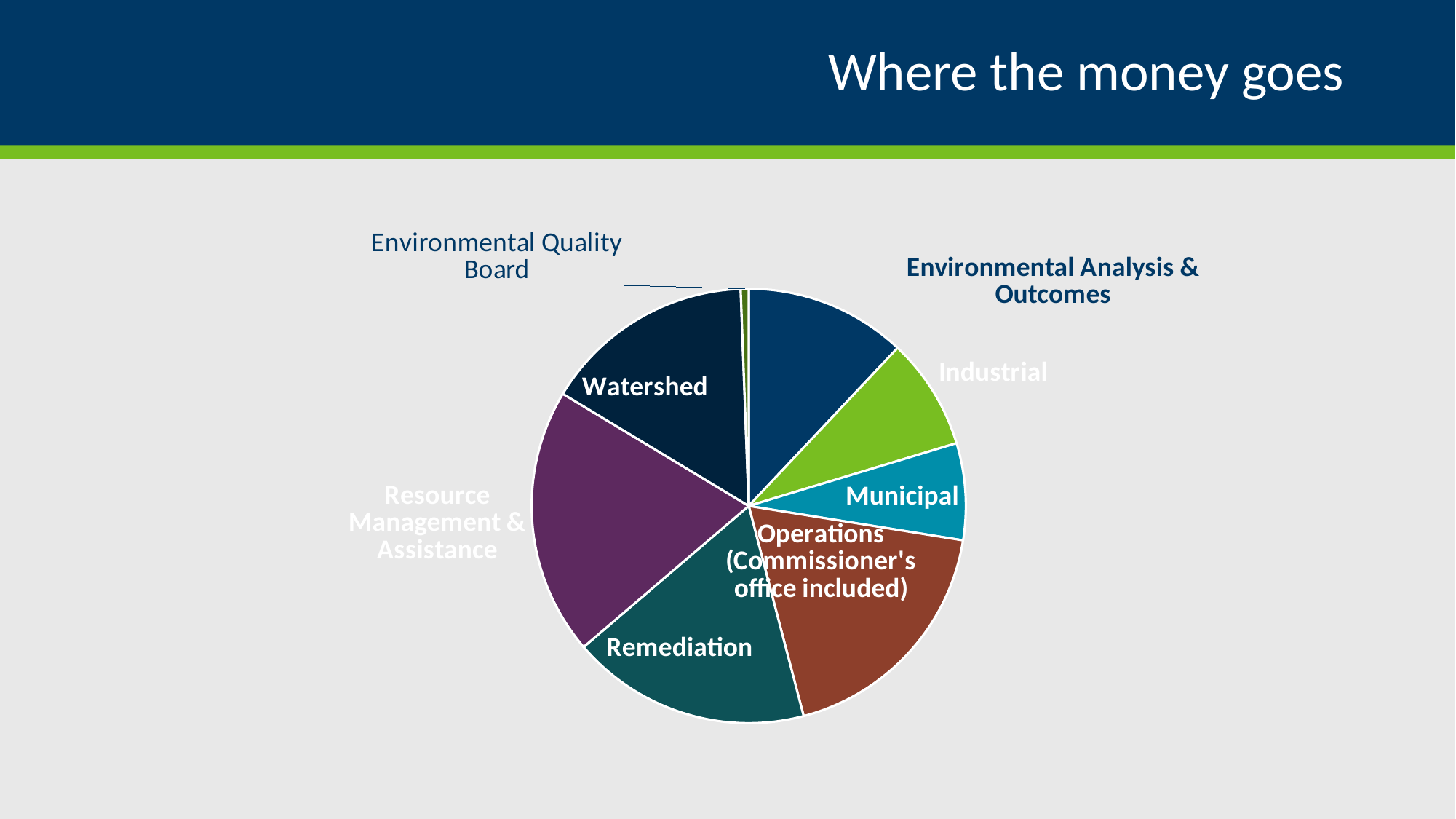
Which slice is larger, Operations (Commissioner's office included) or Industrial? Operations (Commissioner's office included) Which slice is larger, Industrial or Municipal? Industrial How many slices does the pie chart have? 8 Which slice is larger, Remediation or Environmental Quality Board? Remediation What colour is the Industrial slice of the pie chart? green Which slice of the pie chart is the smallest? Environmental Quality Board What kind of chart is shown on the slide? pie chart What is the title of the slide containing the pie chart? Where the money goes